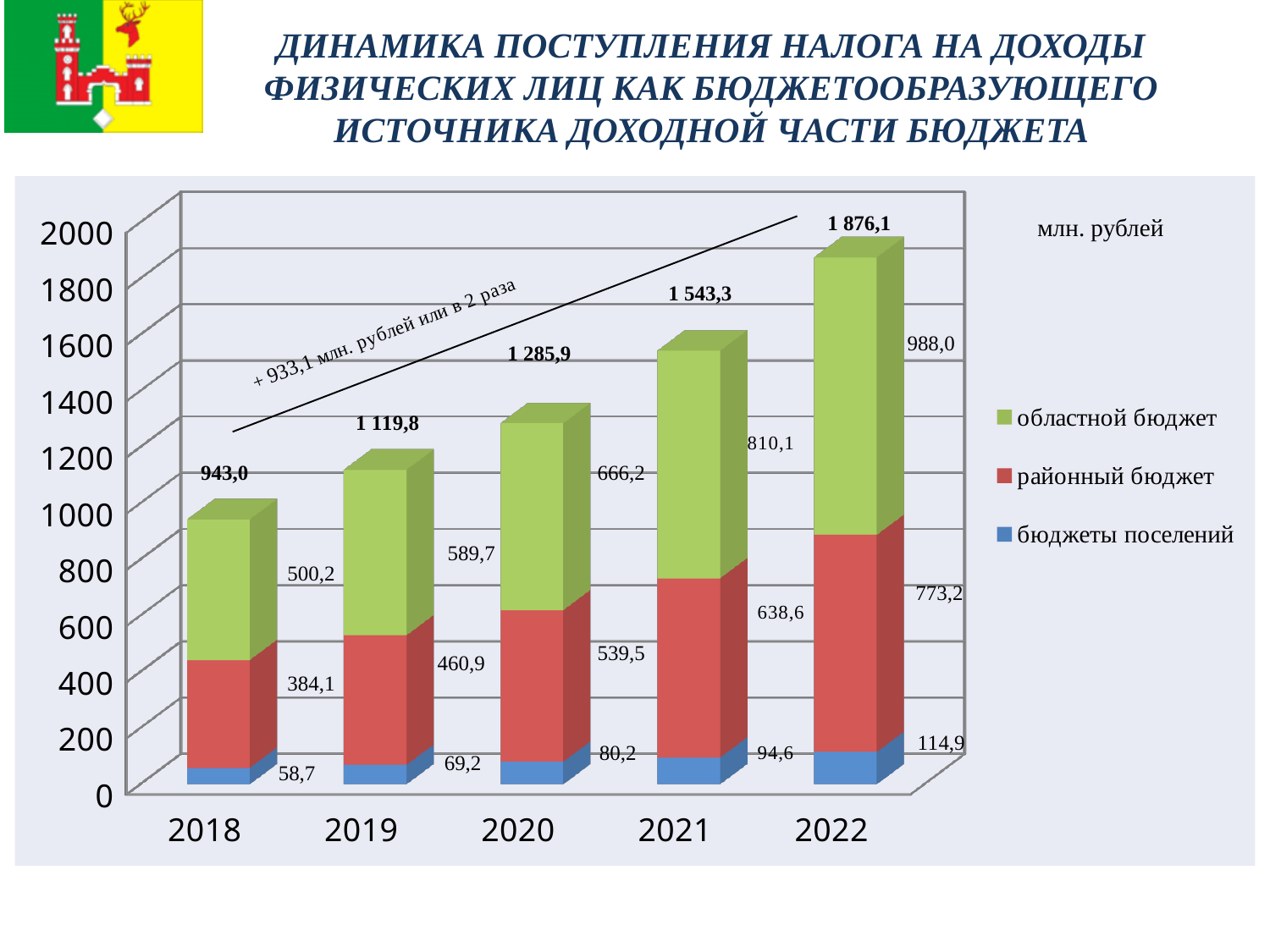
What is the value for районный бюджет in 2019? 460,9 What is the total of the stacked bar for 2021? 1 543,3 Which year has the lowest value for бюджеты поселений? 2018 What is the value for областной бюджет in 2020? 666,2 How many series does the legend list? 3 Which year has the highest total? 2022 What kind of chart is shown on the slide? Stacked bar chart Which is larger: областной бюджет in 2019 or районный бюджет in 2021? районный бюджет in 2021 What is the difference between the районный бюджет values for 2022 and 2018? 389,1 Do the total values rise or fall from 2018 to 2022? Rise How many years are shown on the x axis? 5 What is the value for бюджеты поселений in 2022? 114,9